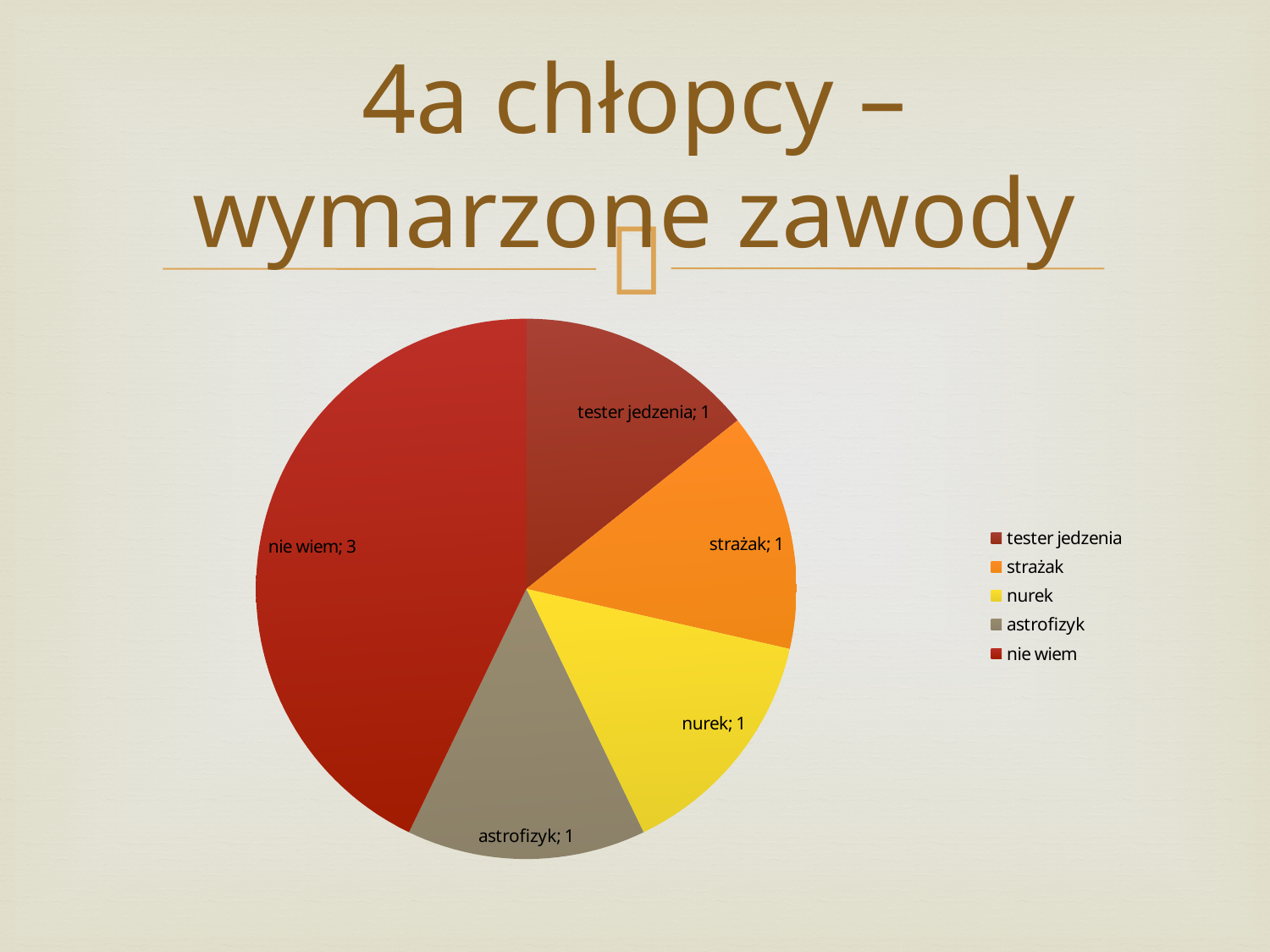
What is the difference between the values for "nie wiem" and "nurek"? 2 Which category has the largest slice in the pie chart? nie wiem How many categories (slices) does the pie chart have? 5 Which is larger, the value for "nie wiem" or the value for "strażak"? nie wiem What colour is the "nurek" slice in the pie chart? yellow What kind of chart is shown on the slide? pie chart What is the value for "tester jedzenia" in the pie chart? 1 What is the value for "astrofizyk" in the pie chart? 1 What is the value for "nie wiem" in the pie chart? 3 How many entries does the legend list? 5 What is the value for "strażak" in the pie chart? 1 What is the title of the slide containing the pie chart? 4a chłopcy – wymarzone zawody